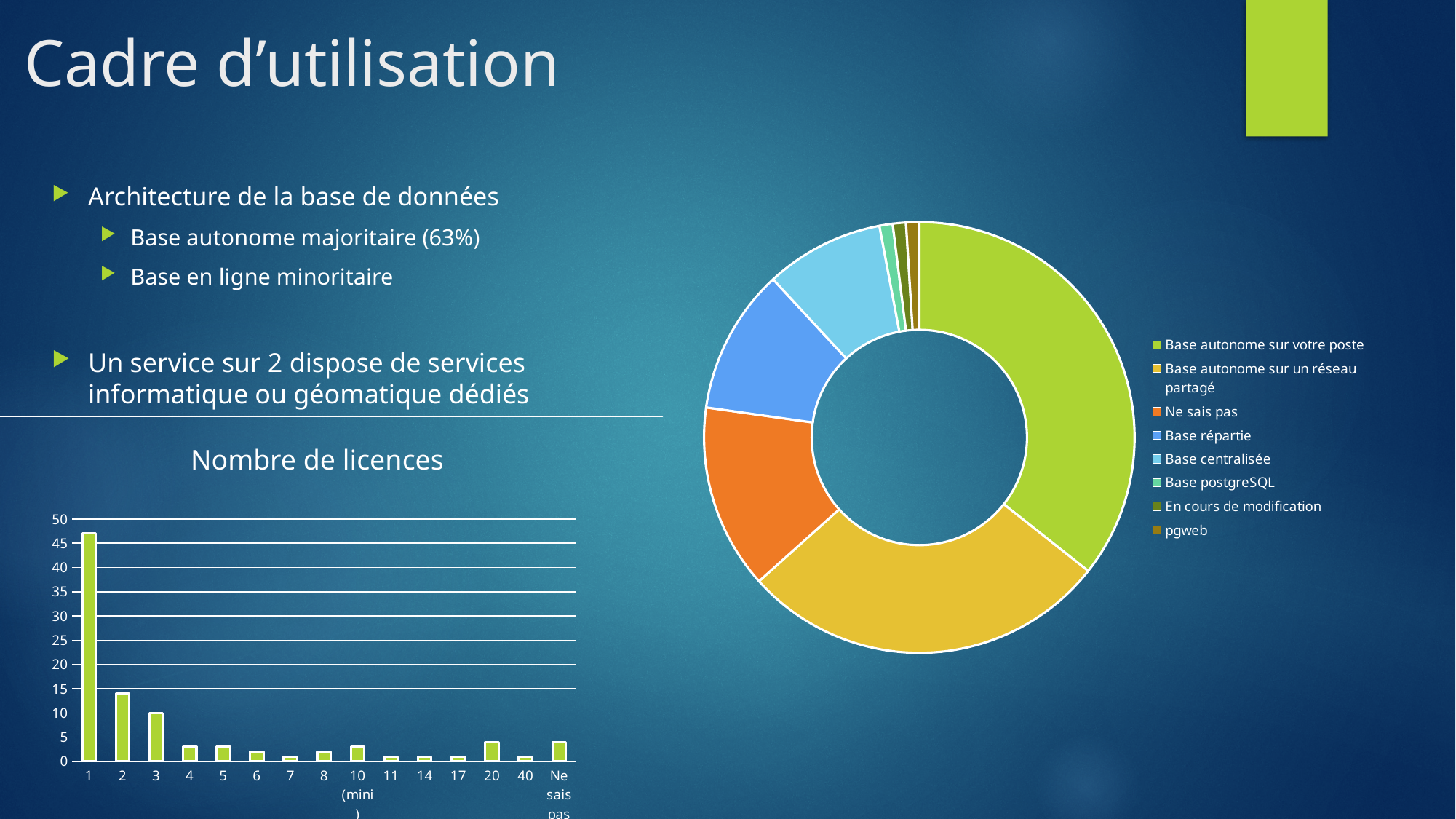
In the doughnut chart on the right, which slice is larger, 'Base autonome sur un réseau partagé' or 'Ne sais pas'? Base autonome sur un réseau partagé How many entries does the legend of the doughnut chart on the right list? 8 What is the title of the bar chart on the slide? Nombre de licences What kind of chart is the 'Nombre de licences' chart? bar chart In the 'Nombre de licences' chart, which category has the highest value? 1 In the 'Nombre de licences' chart, is the value for category 20 greater or less than 10? less In the doughnut chart on the right, which category has the largest slice? Base autonome sur votre poste In the 'Nombre de licences' chart, is the value for category 2 greater or less than 10? greater What kind of chart is the chart on the right of the slide with the legend starting 'Base autonome sur votre poste'? doughnut chart In the 'Nombre de licences' chart, which has the larger value, category 2 or category 3? 2 How many categories are shown on the x axis of the 'Nombre de licences' chart? 15 In the 'Nombre de licences' chart, is the value for category 1 greater or less than 45? greater